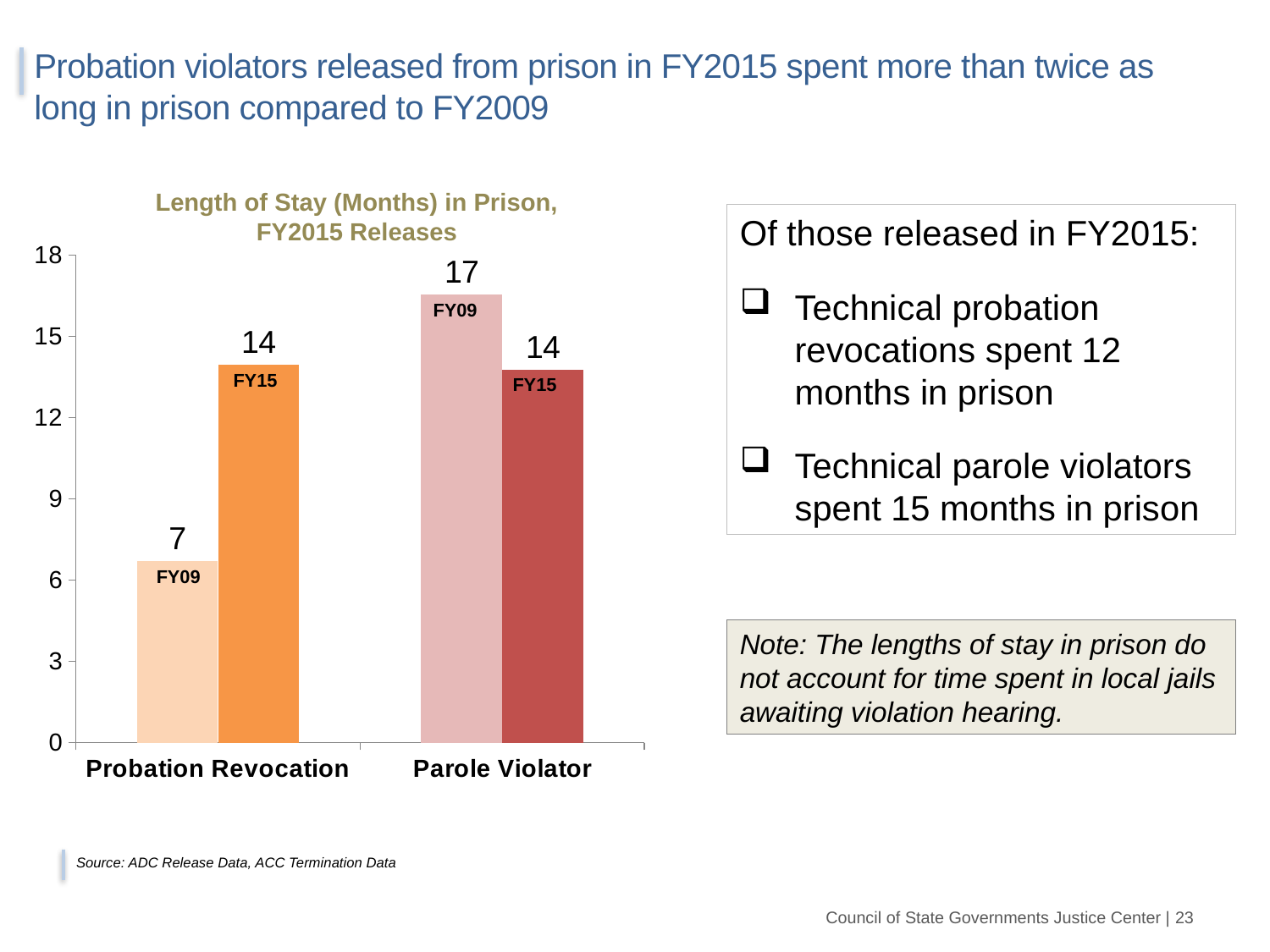
What is the length of stay in prison for Parole Violator in FY15? 14 What is the length of stay in prison for Probation Revocation in FY15? 14 How many categories are shown on the x axis of the chart? 2 Which is larger: the FY09 length of stay for Probation Revocation or the FY09 length of stay for Parole Violator? Parole Violator What is the length of stay in prison for Probation Revocation in FY09? 7 What is the difference in length of stay for Parole Violator between FY09 and FY15? 3 What is the length of stay in prison for Parole Violator in FY09? 17 What is the difference in length of stay for Probation Revocation between FY15 and FY09? 7 What kind of chart is shown on the slide? Bar chart Which bar shows the lowest length of stay in the chart? Probation Revocation FY09 What is the title of the chart? Length of Stay (Months) in Prison, FY2015 Releases Which bar shows the highest length of stay in the chart? Parole Violator FY09